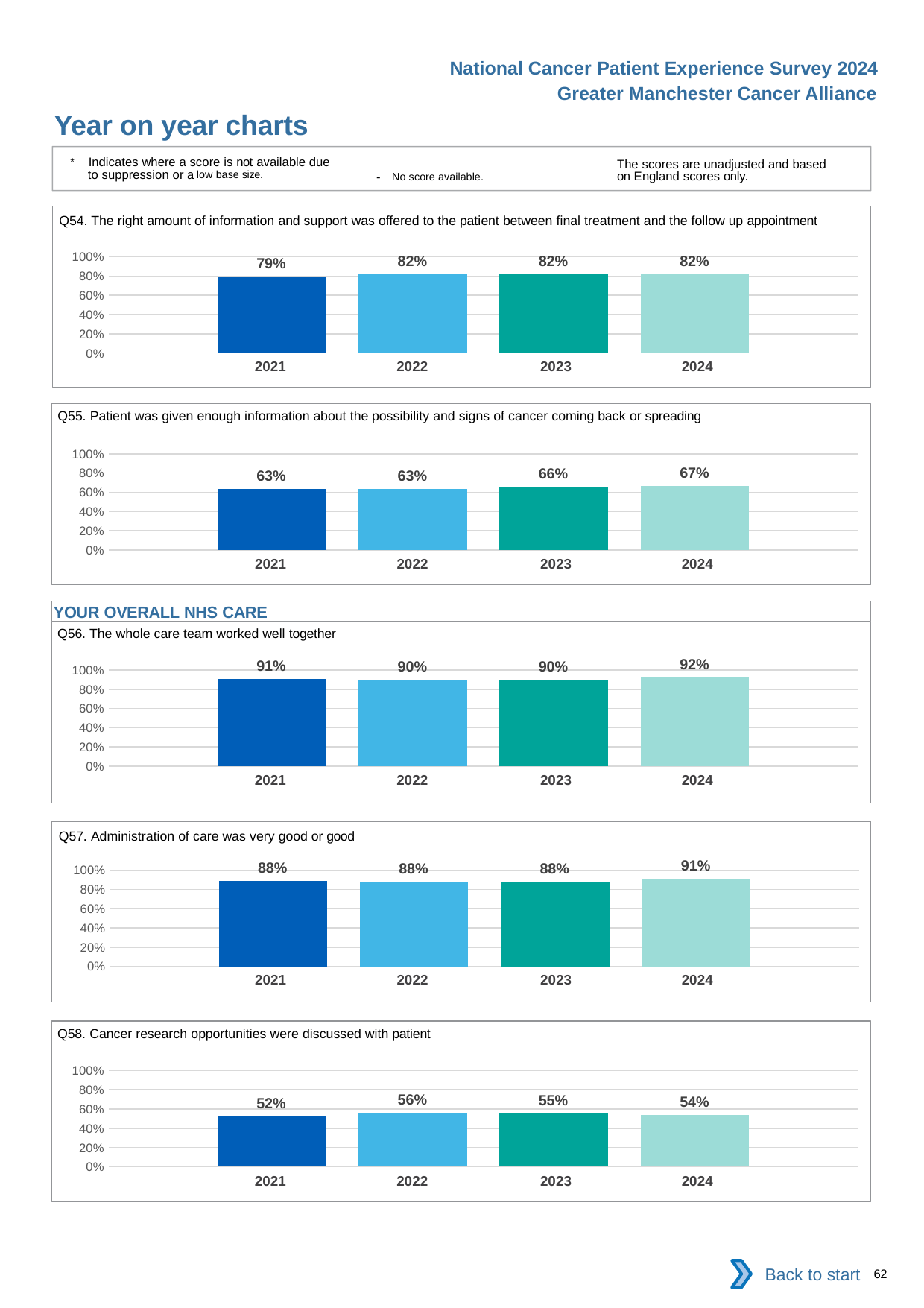
In the Q58 chart, what is the value for 2022? 56% In the Q57 chart, what is the difference between the 2024 value and the 2023 value? 3% In the Q58 chart, is the value for 2022 greater or less than 80%? less In the Q58 chart, which year has the lowest value? 2021 In the Q56 chart, which year has the highest value? 2024 How many years are shown on the x axis of the Q54 chart? 4 In the Q55 chart, what is the value for 2024? 67% What is the section heading shown above the Q56 chart? YOUR OVERALL NHS CARE What kind of chart is the Q56 chart? bar chart In the Q55 chart, do the values generally rise or fall from 2021 to 2024? rise In the Q54 chart, what is the value for 2021? 79% In the Q55 chart, is the value for 2023 larger or smaller than the value for 2021? larger